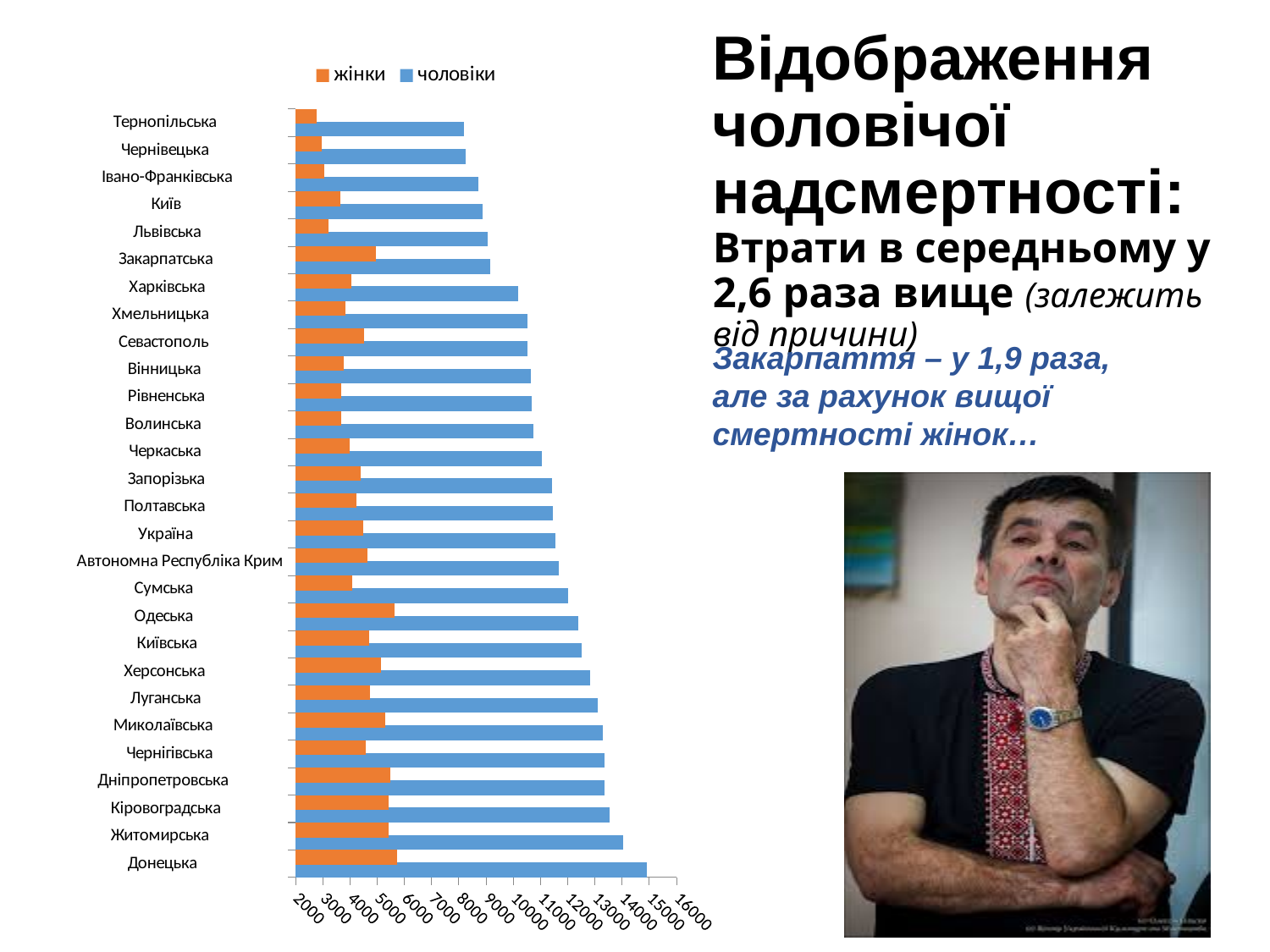
Is the value for чоловіки in Донецька greater or less than 14000? greater Which category has the highest value for чоловіки? Донецька What kind of chart is shown on the slide? bar chart How many categories (regions) are plotted on the chart? 28 Is the value for жінки in Закарпатська greater or less than 4000? greater Which category has the lowest value for жінки? Тернопільська How many series does the chart legend list? 2 Is the value for чоловіки in Тернопільська greater or less than 9000? less Which is larger: the чоловіки value for Донецька or for Тернопільська? Донецька Which is larger: the жінки value for Одеська or for Львівська? Одеська Which colour represents the series жінки in the chart? orange